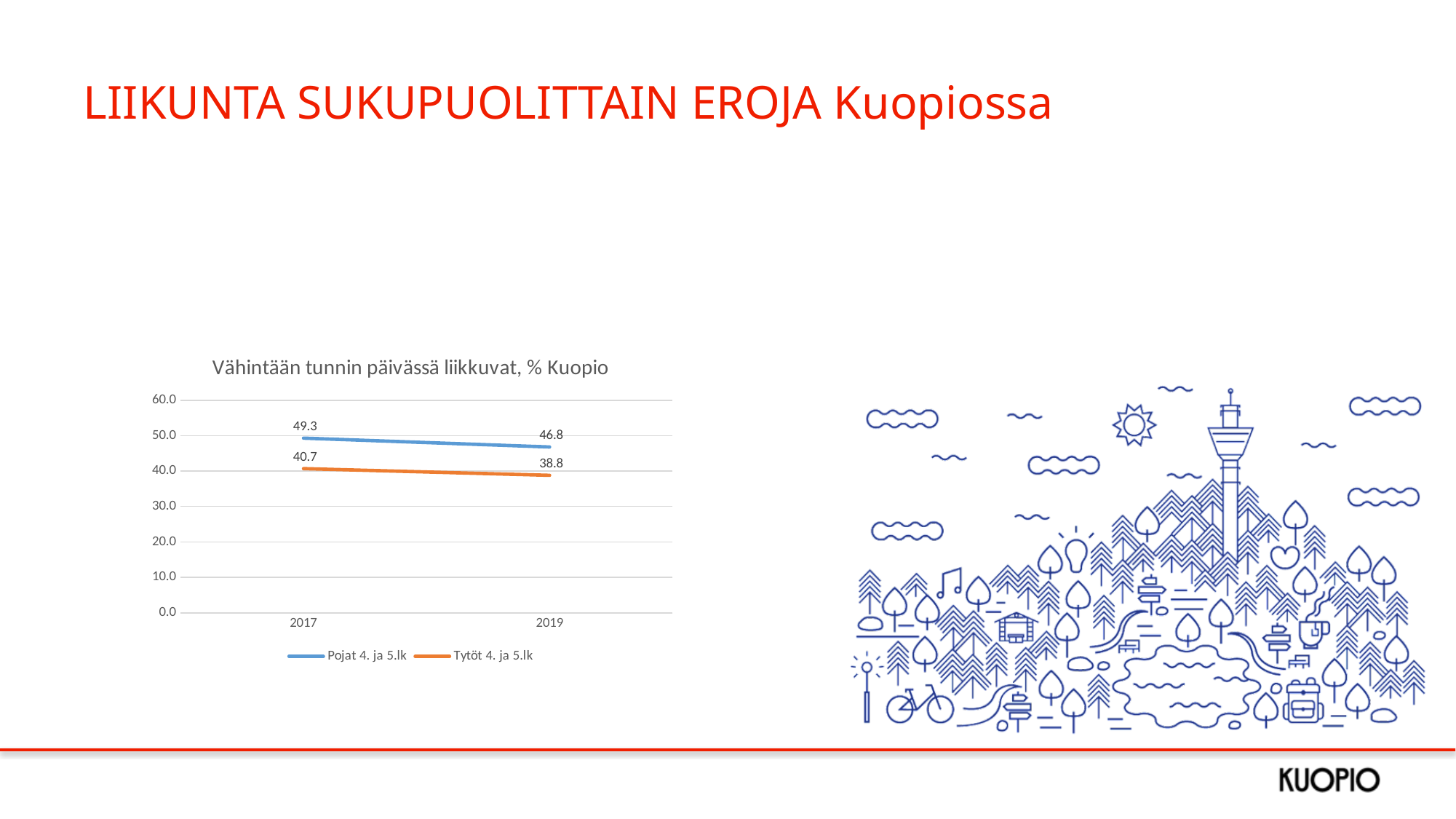
What is the title of the chart? Vähintään tunnin päivässä liikkuvat, % Kuopio Which series has the higher value in 2019, Pojat 4. ja 5.lk or Tytöt 4. ja 5.lk? Pojat 4. ja 5.lk What is the value for Pojat 4. ja 5.lk in 2019? 46.8 By how much did the Pojat 4. ja 5.lk value change from 2017 to 2019? 2.5 What is the difference between the Pojat 4. ja 5.lk and Tytöt 4. ja 5.lk values in 2017? 8.6 How many series does the legend list? 2 What is the value for Tytöt 4. ja 5.lk in 2017? 40.7 Does the Tytöt 4. ja 5.lk series rise or fall from 2017 to 2019? fall What is the value for Pojat 4. ja 5.lk in 2017? 49.3 How many years are shown on the x axis? 2 What kind of chart is shown on the slide? line chart What is the value for Tytöt 4. ja 5.lk in 2019? 38.8